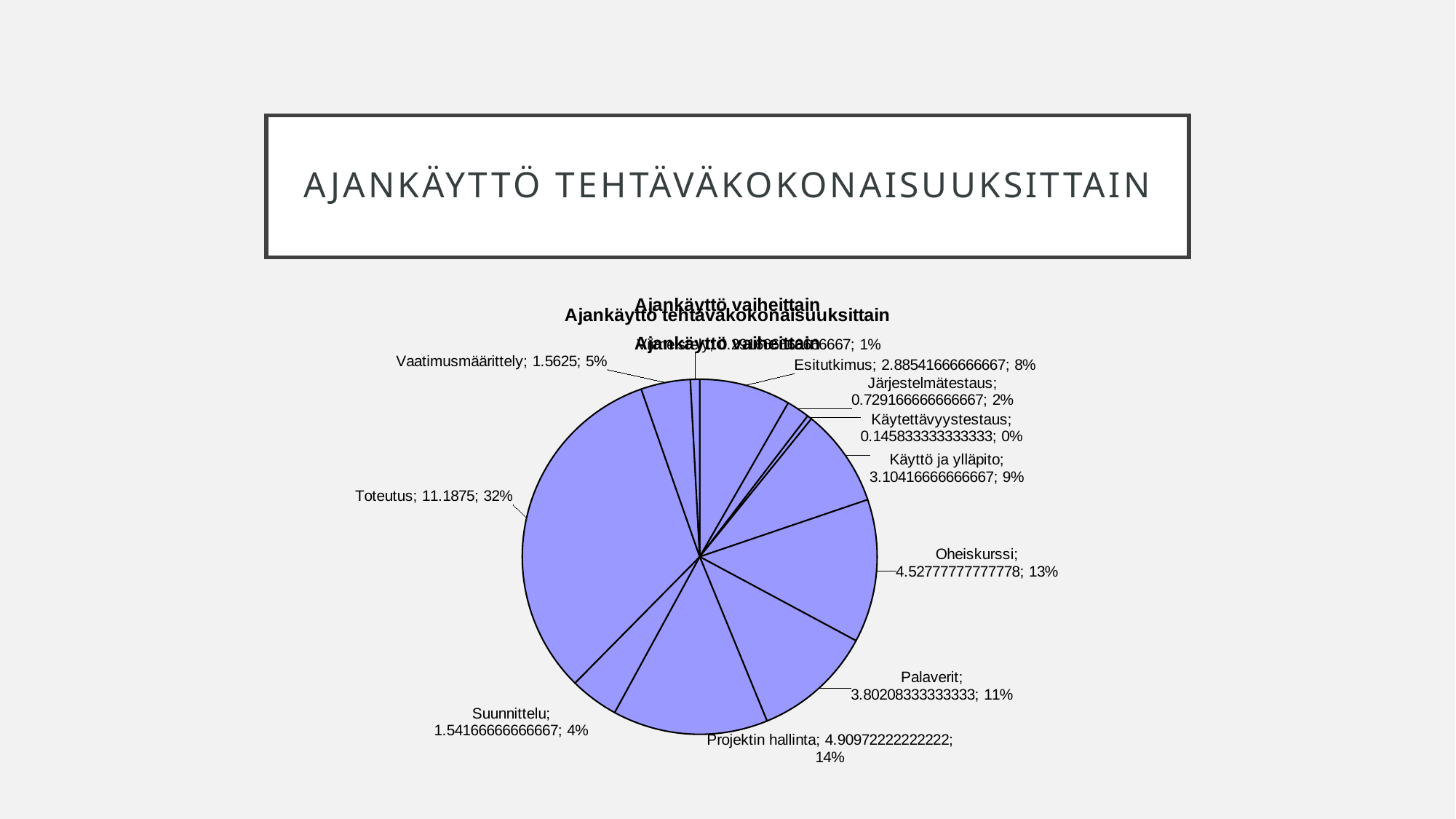
What value is shown for Palaverit? 3.80208333333333 Which is larger, the value for Oheiskurssi or the value for Palaverit? Oheiskurssi What value is shown for Vaatimusmäärittely? 1.5625 Which is larger, the value for Esitutkimus or the value for Järjestelmätestaus? Esitutkimus Which category has the smallest slice of the pie? Käytettävyystestaus What value is shown for Toteutus? 11.1875 What value is shown for Oheiskurssi? 4.52777777777778 What share of the pie does Käyttö ja ylläpito represent? 9% Which category has the largest slice of the pie? Toteutus What share of the pie does Toteutus represent? 32% What share of the pie does Projektin hallinta represent? 14% What kind of chart is shown on the slide? pie chart